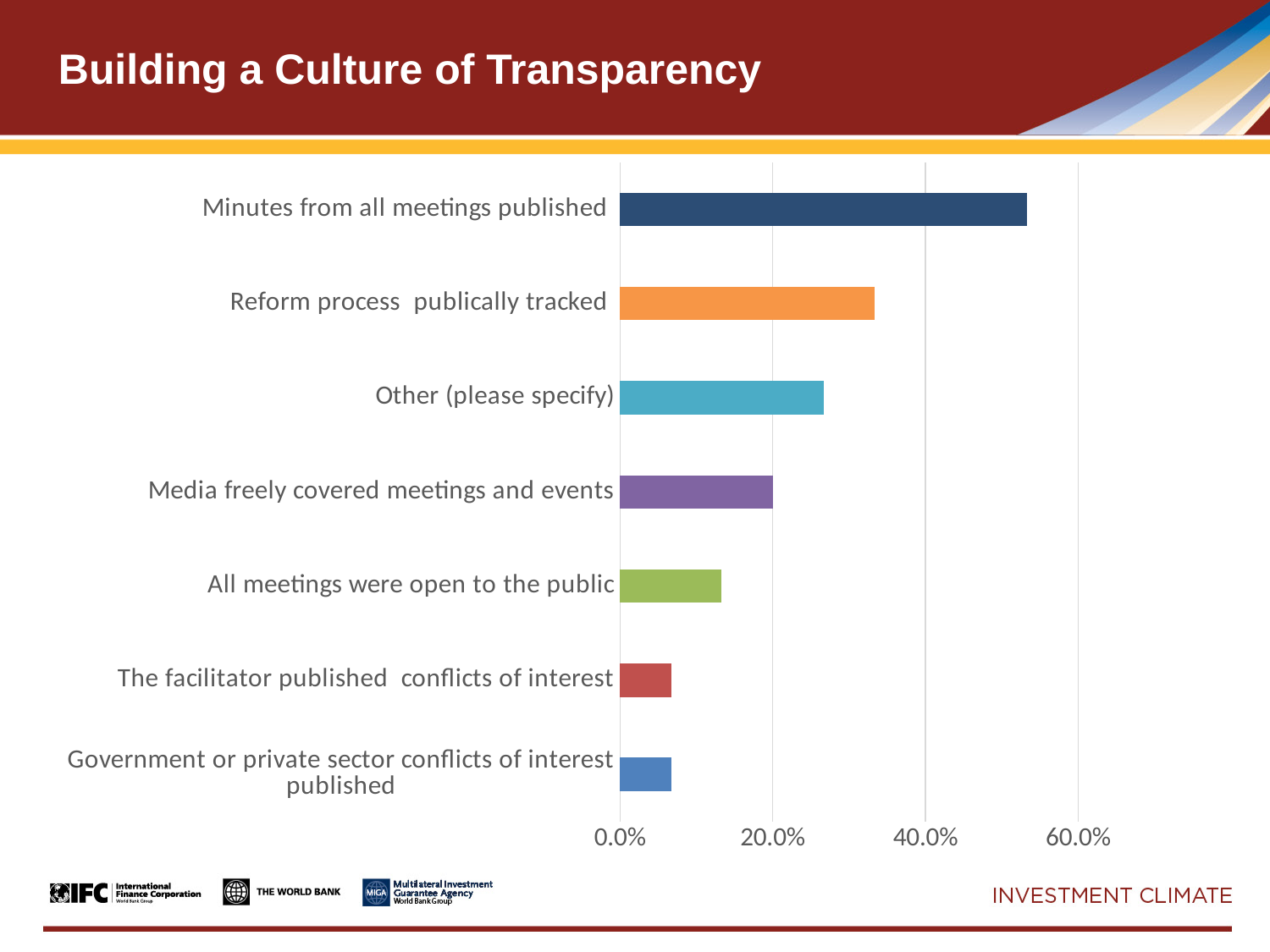
Is the value for "The facilitator published conflicts of interest" greater or less than 20.0%? less Is the value for "All meetings were open to the public" greater or less than 20.0%? less Which is larger: the value for "Reform process publically tracked" or for "Other (please specify)"? Reform process publically tracked What is the title of the slide containing the chart? Building a Culture of Transparency Is the value for "Other (please specify)" greater or less than 40.0%? less Which is larger: the value for "Media freely covered meetings and events" or for "All meetings were open to the public"? Media freely covered meetings and events Which is larger: the value for "Minutes from all meetings published" or for "Reform process publically tracked"? Minutes from all meetings published What kind of chart is shown on the slide? bar chart How many categories are plotted in the chart? 7 Which category has the highest value in the chart? Minutes from all meetings published